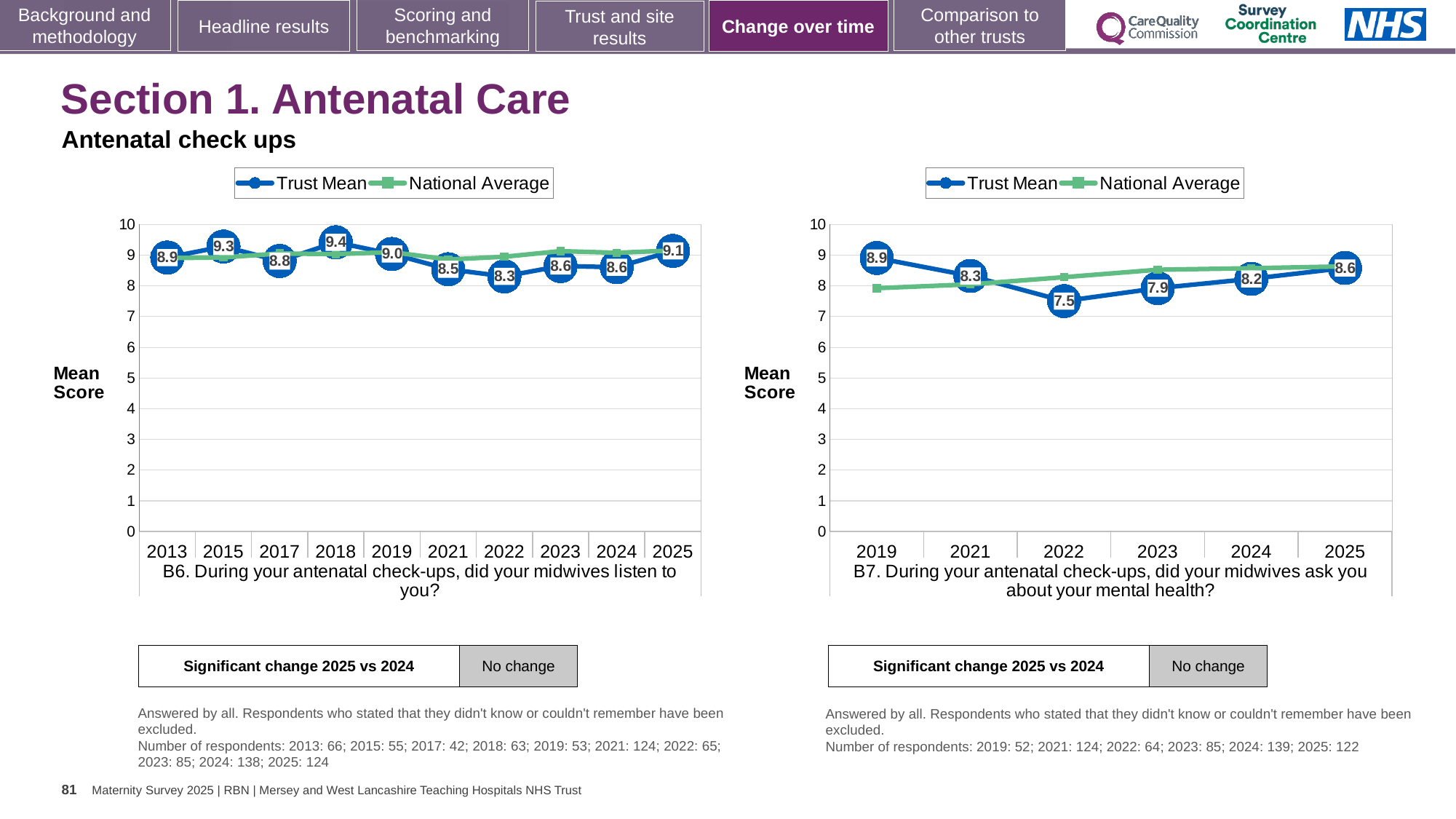
In the left chart (B6), which year has the lowest Trust Mean score? 2022 In the left chart (B6), what is the Trust Mean score for 2018? 9.4 In the right chart (B7), how many series does the legend list? 2 In the right chart (B7), which year has the highest Trust Mean score? 2019 In the left chart (B6), what is the Trust Mean score for 2022? 8.3 In the right chart (B7), what is the Trust Mean score for 2022? 7.5 What type of chart is used on the left (B6)? Line chart In the left chart (B6), how many years are shown on the x axis? 10 In the left chart (B6), which year has the highest Trust Mean score? 2018 In the right chart (B7), is the National Average value for 2019 greater or less than 9? less In the right chart (B7), is the Trust Mean score for 2019 larger or smaller than the score for 2025? larger In the left chart (B6), what is the difference between the Trust Mean scores for 2025 and 2024? 0.5